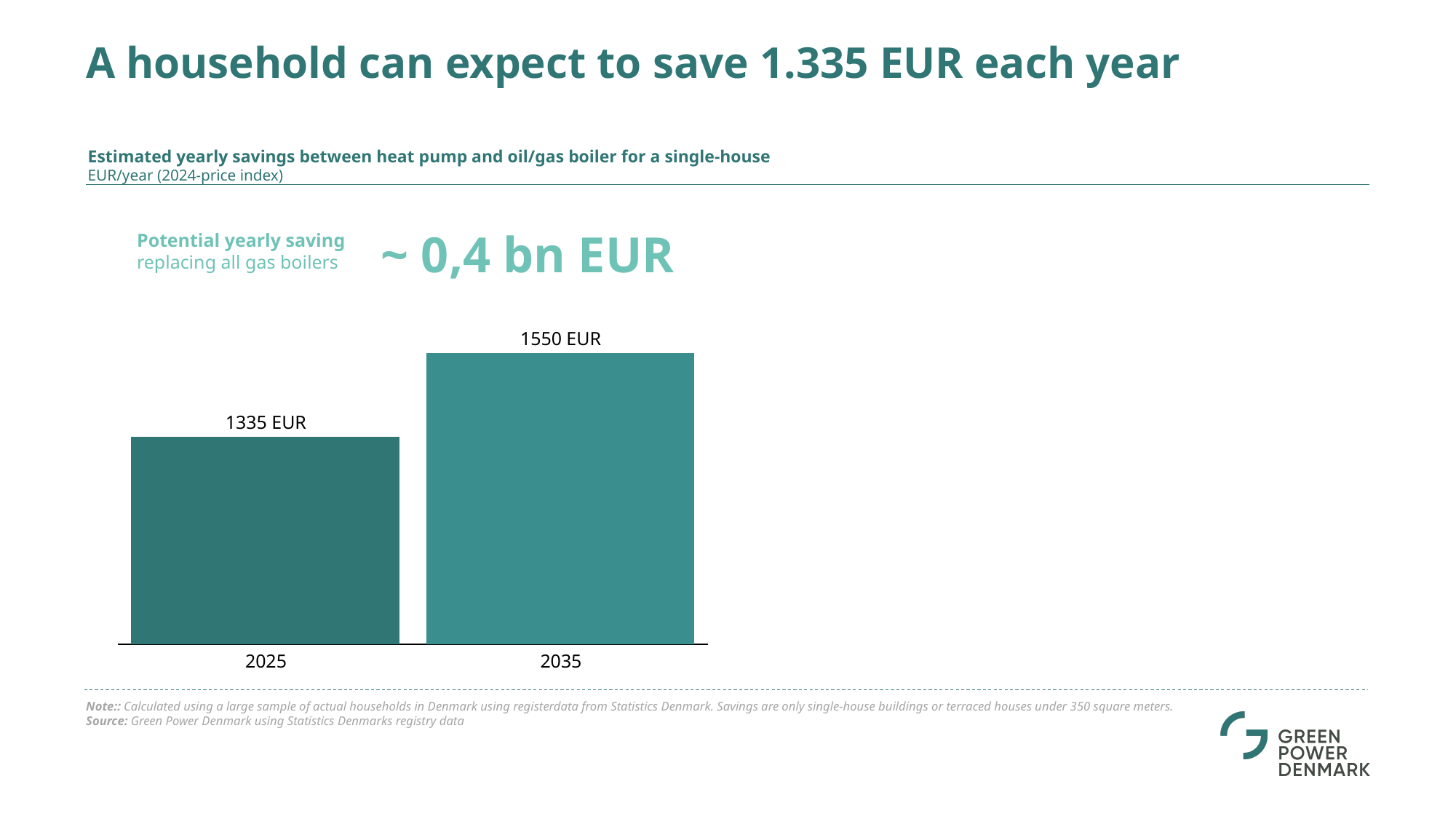
How many years are shown on the chart? 2 Which year has the higher estimated yearly saving? 2035 Which year has the lower estimated yearly saving? 2025 What unit are the values on the chart expressed in? EUR/year (2024-price index) What is the estimated yearly saving for 2035? 1550 EUR Is the estimated yearly saving larger in 2025 or in 2035? 2035 Do the estimated yearly savings rise or fall from 2025 to 2035? Rise What is the title of the chart? Estimated yearly savings between heat pump and oil/gas boiler for a single-house What is the difference between the estimated yearly saving in 2035 and in 2025? 215 EUR What is the estimated yearly saving for 2025? 1335 EUR What kind of chart is shown on the slide? Bar chart